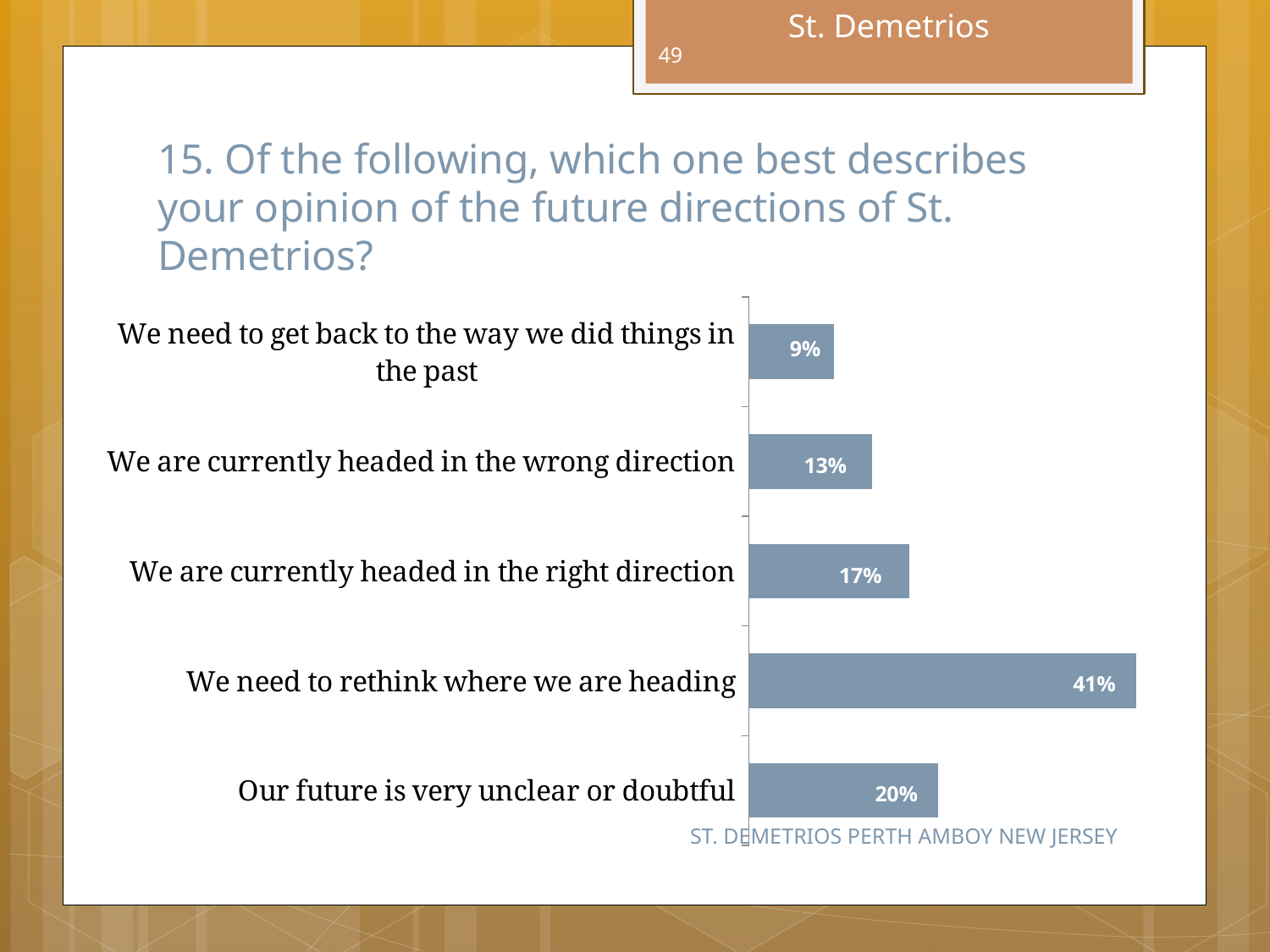
How many response options are shown in the chart? 5 Which response option has the highest percentage? We need to rethink where we are heading Which response option has the lowest percentage? We need to get back to the way we did things in the past What percentage chose "We are currently headed in the right direction"? 17% What is the value for "We need to get back to the way we did things in the past"? 9% What is the difference between "We are currently headed in the right direction" and "We are currently headed in the wrong direction"? 4% What is the total of "We are currently headed in the right direction" and "We are currently headed in the wrong direction"? 30% What kind of chart is shown on the slide? Bar chart What percentage of respondents chose "We need to rethink where we are heading"? 41% What is the difference between "We need to rethink where we are heading" and "Our future is very unclear or doubtful"? 21% What is the value for "Our future is very unclear or doubtful"? 20% Which is larger: "We are currently headed in the wrong direction" or "Our future is very unclear or doubtful"? Our future is very unclear or doubtful